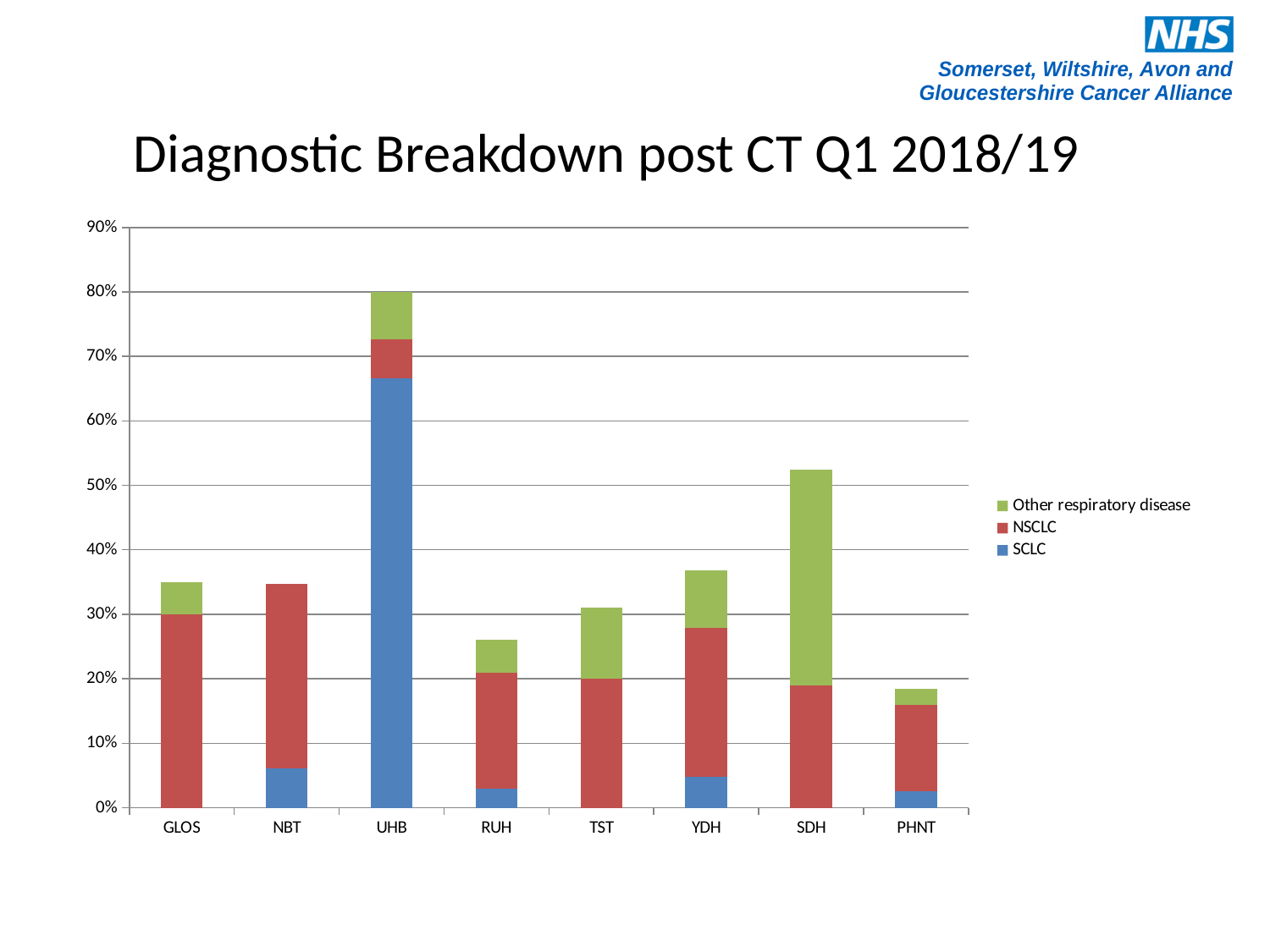
What kind of chart is shown on the slide? Stacked bar chart How many series does the legend list? 3 Is the total bar height for RUH greater or less than 30%? less Is the total bar height for UHB greater or less than 70%? greater Which category has the largest SCLC (blue) segment? UHB Which category has the tallest stacked bar overall? UHB How many categories (hospitals) are shown on the x axis? 8 Is the total bar height for PHNT greater or less than 20%? less Which category has the largest Other respiratory disease (green) segment? SDH Which has the taller stacked bar, YDH or TST? YDH Which category has the shortest stacked bar overall? PHNT